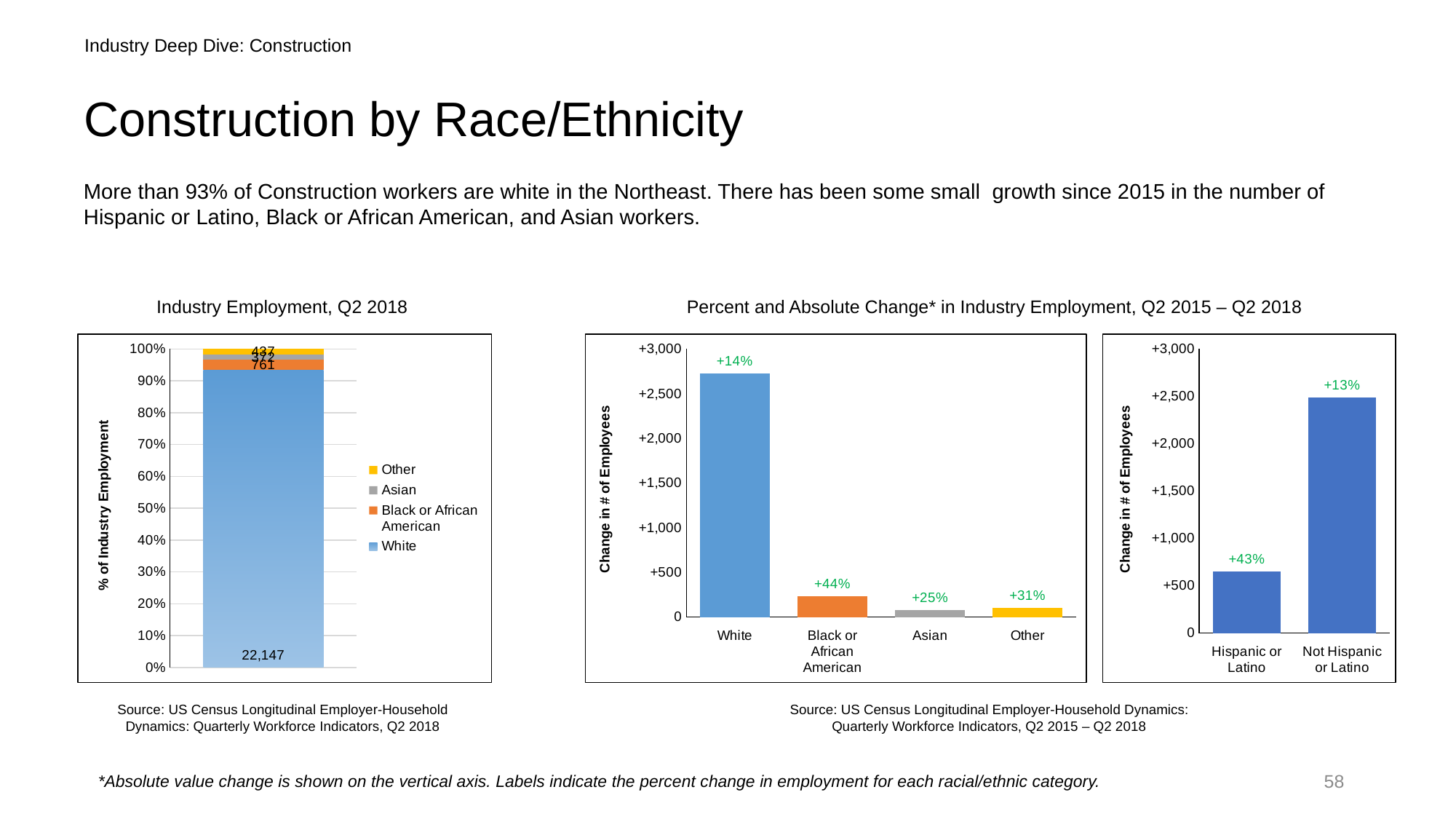
In the Percent and Absolute Change chart by race (middle chart), is the bar for White greater or less than +2,500? greater In the Percent and Absolute Change chart by ethnicity (right chart), is the bar for Not Hispanic or Latino greater or less than +2,000? greater In the Percent and Absolute Change chart by race (middle chart), what percent change is labeled for Black or African American? +44% In the Percent and Absolute Change chart by race (middle chart), which category has the tallest bar? White In the Percent and Absolute Change chart by race (middle chart), which category has the shortest bar? Asian How many series does the legend of the Industry Employment, Q2 2018 chart list? 4 In the Percent and Absolute Change chart by race (middle chart), what percent change is labeled for White? +14% What kind of chart is the Industry Employment, Q2 2018 chart? Stacked bar chart In the Percent and Absolute Change chart by ethnicity (right chart), what percent change is labeled for Hispanic or Latino? +43% How many categories are shown on the x axis of the Percent and Absolute Change chart by race (middle chart)? 4 In the Industry Employment, Q2 2018 chart, what value is labeled on the White segment? 22,147 In the Percent and Absolute Change chart by ethnicity (right chart), which bar is taller, Hispanic or Latino or Not Hispanic or Latino? Not Hispanic or Latino